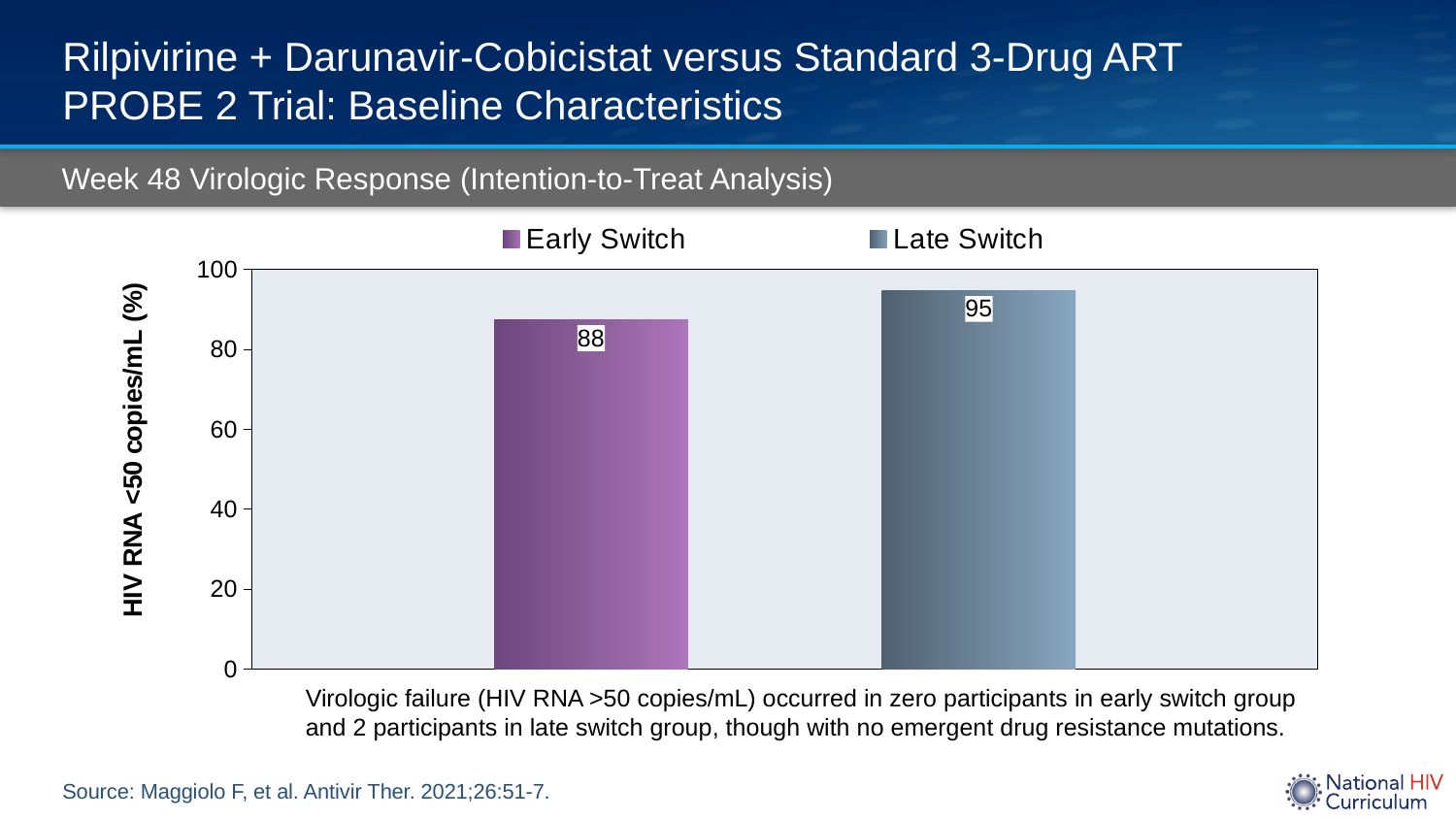
Which group has the lower value? Early Switch How many series does the legend list? 2 What is the value for Early Switch? 88 Which group has the higher value, Early Switch or Late Switch? Late Switch What is the title of the chart? Week 48 Virologic Response (Intention-to-Treat Analysis) What is the difference between the Late Switch and Early Switch values? 7 What is the value for Late Switch? 95 What kind of chart is shown on the slide? Bar chart Is the value for Late Switch greater or less than 100? less Is the value for Early Switch greater or less than 80? greater What is the label of the y axis? HIV RNA <50 copies/mL (%) How many bars are plotted in the chart? 2